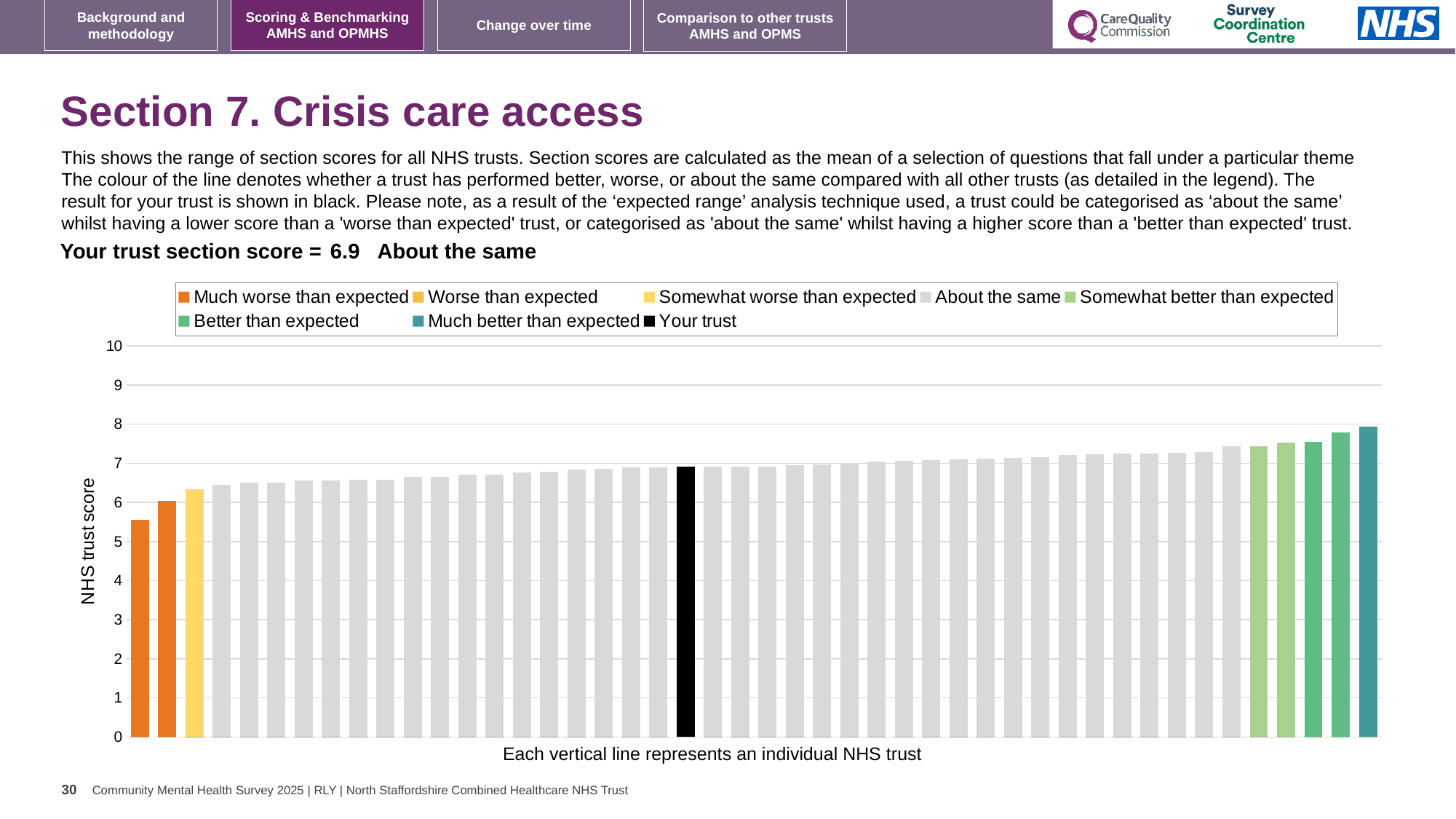
What is the section score for your trust shown on the slide? 6.9 Is the value of the rightmost (tallest) bar greater or less than 7? greater How many bars are coloured as 'Much worse than expected' (orange)? 2 How many entries does the chart legend list? 8 Do the bar values rise or fall from left to right across the chart? Rise Which category is your trust placed in for Section 7 Crisis care access? About the same Which legend category does the shortest bar in the chart belong to? Much worse than expected Which legend category does the tallest bar in the chart belong to? Much better than expected Is the value of the leftmost (lowest) bar greater or less than 6? less What kind of chart is shown on the slide? Bar chart Is the value of the black 'Your trust' bar greater or less than 5? greater